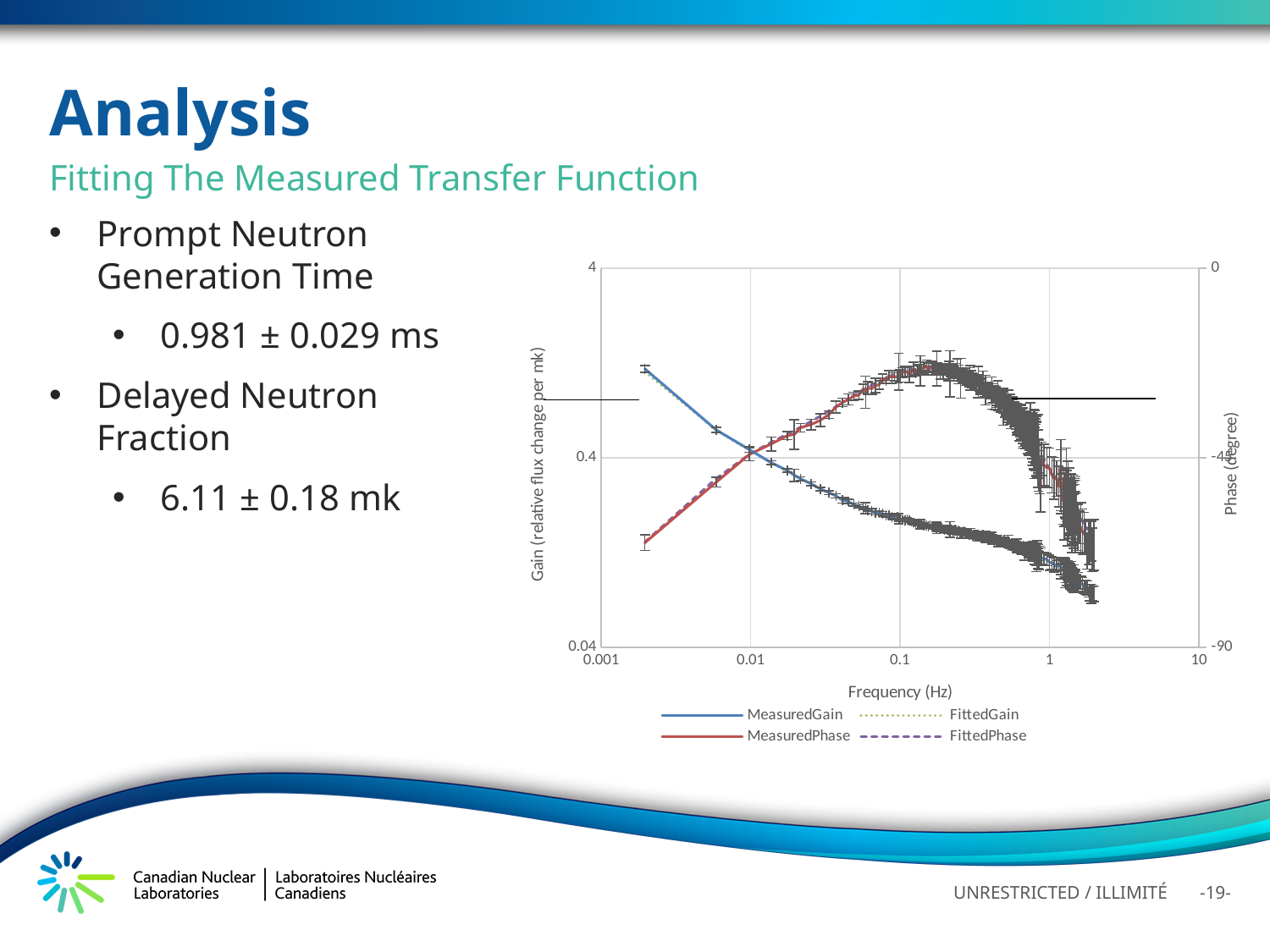
Is the MeasuredPhase value at 0.002 Hz greater or less than -45 degrees? less Which is larger, the MeasuredGain value at 0.002 Hz or the MeasuredGain value at 1 Hz? MeasuredGain at 0.002 Hz Is the MeasuredPhase value at 0.1 Hz greater or less than -45 degrees? greater Is the MeasuredGain value at 0.002 Hz greater or less than 4? less Does the MeasuredGain series rise or fall as frequency increases along the x axis? fall Which series are listed in the chart legend? MeasuredGain, FittedGain, MeasuredPhase, FittedPhase How many series does the chart legend list? 4 What is the label of the x axis of the chart? Frequency (Hz) What kind of chart is shown on the slide? line chart